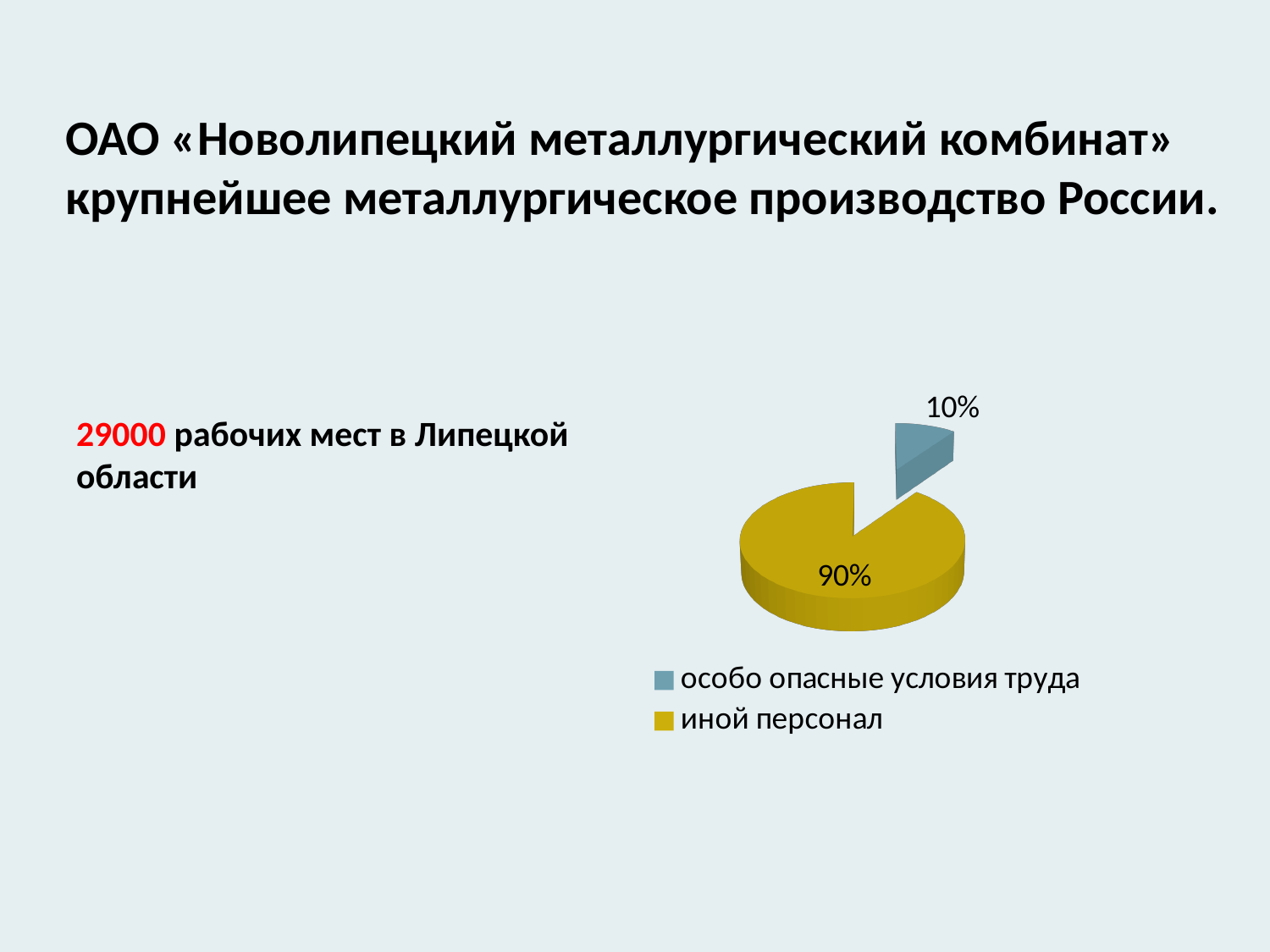
Which category has the smallest slice of the pie? особо опасные условия труда How many entries does the legend list? 2 What share of the pie does "особо опасные условия труда" represent? 10% What is the difference in percentage points between the "иной персонал" slice and the "особо опасные условия труда" slice? 80 What share of the pie does "иной персонал" represent? 90% What colour is the slice for "иной персонал"? yellow Which category has the largest slice of the pie? иной персонал What kind of chart is shown on the slide? pie chart Which slice is larger: "особо опасные условия труда" or "иной персонал"? иной персонал How many slices does the pie chart have? 2 What colour is the slice for "особо опасные условия труда"? blue-grey